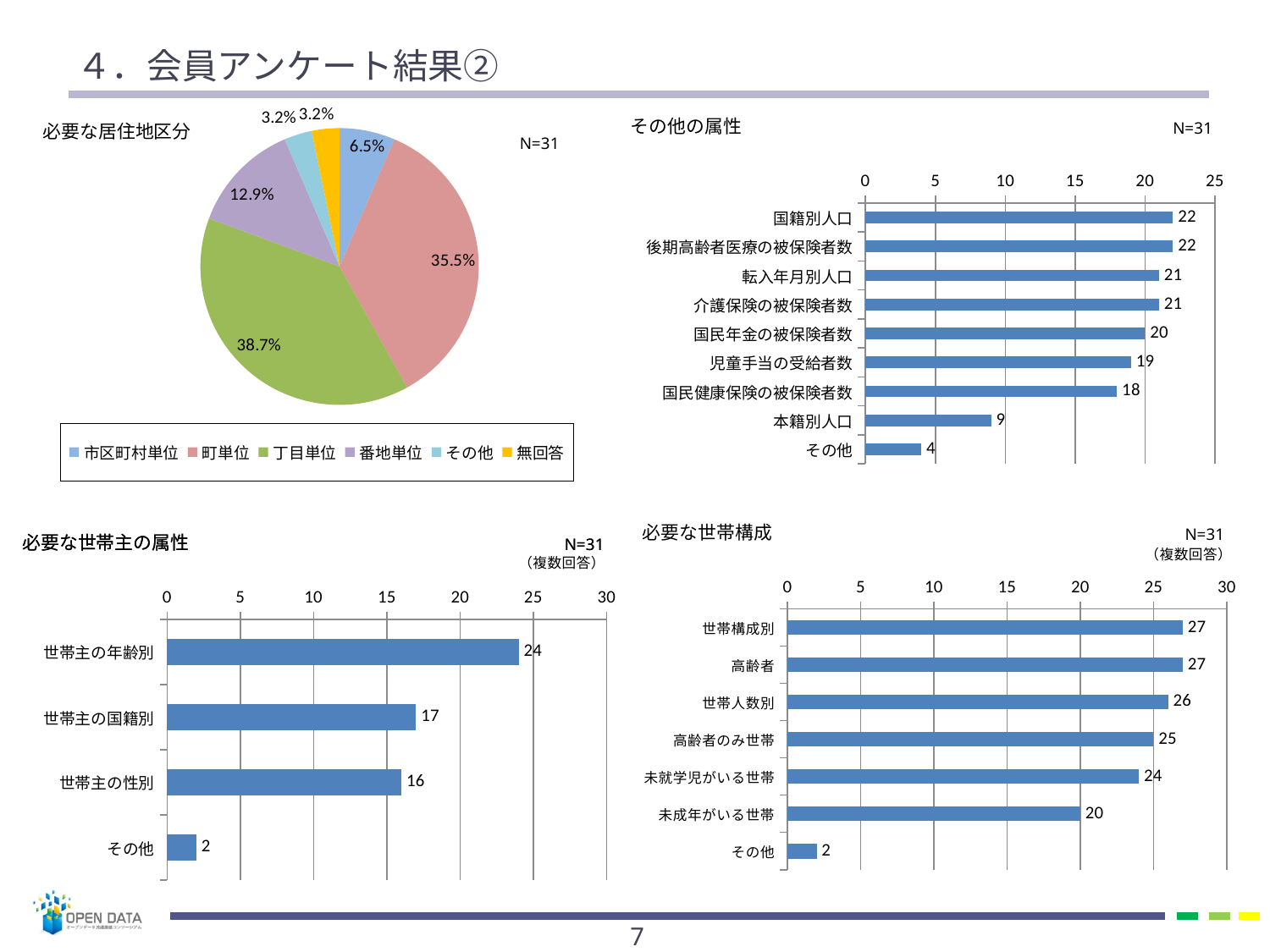
In the pie chart titled 必要な居住地区分, what is the share for 番地単位? 12.9% In the chart titled 必要な世帯主の属性, which is larger, 世帯主の国籍別 or 世帯主の性別? 世帯主の国籍別 In the chart titled 必要な世帯構成, what is the value for 未就学児がいる世帯? 24 In the chart titled その他の属性, what is the difference between 国籍別人口 and 国民健康保険の被保険者数? 4 In the pie chart titled 必要な居住地区分, which category has the largest share? 丁目単位 In the pie chart titled 必要な居住地区分, what share does 丁目単位 have? 38.7% In the chart titled 必要な世帯主の属性, what is the value for 世帯主の年齢別? 24 In the chart titled その他の属性, what is the value for 本籍別人口? 9 How many categories are shown in the chart titled その他の属性? 9 What kind of chart is the one titled 必要な世帯構成? bar chart In the chart titled その他の属性, which category has the lowest value? その他 How many entries does the legend of the pie chart titled 必要な居住地区分 list? 6